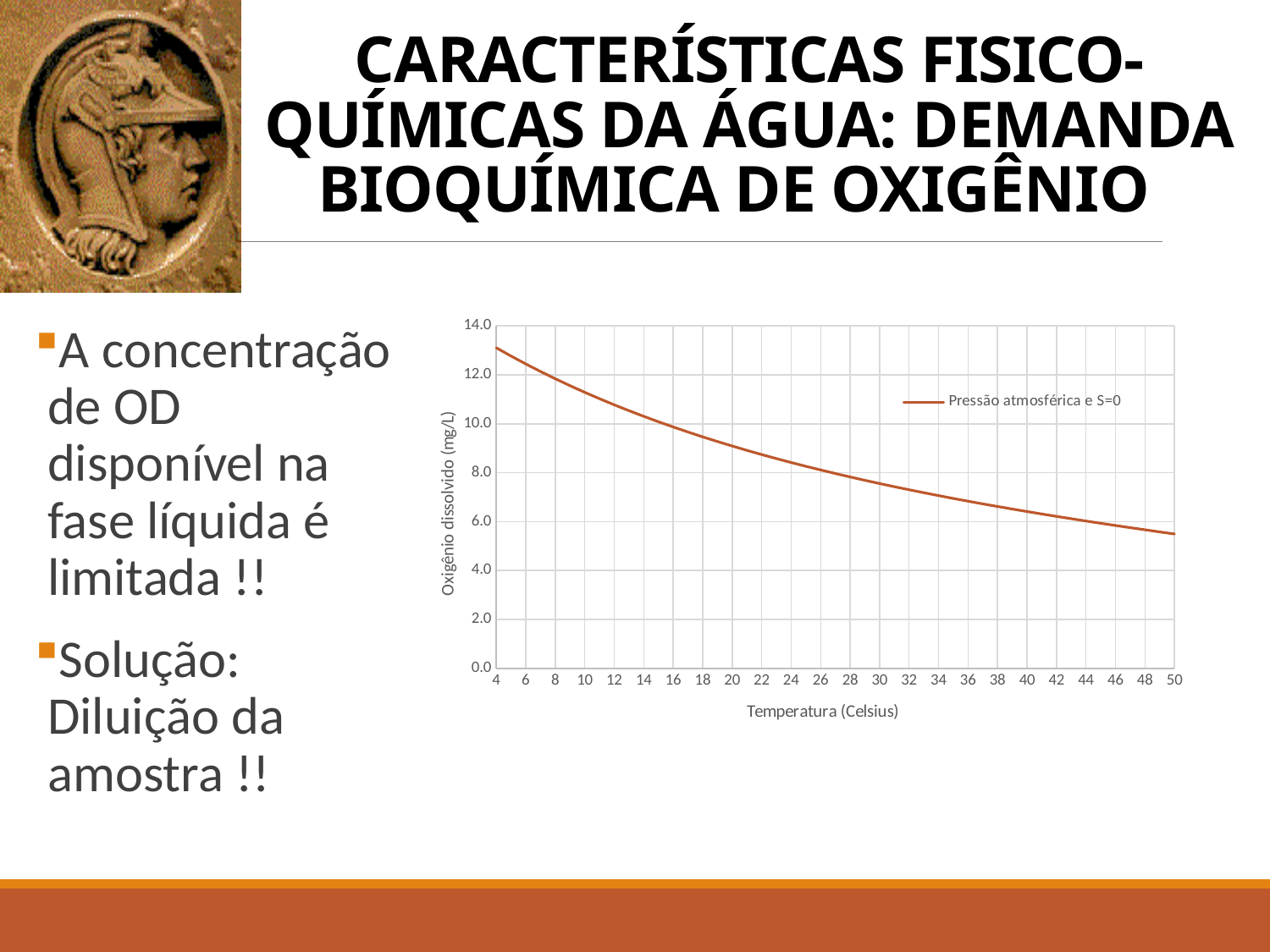
How many series does the chart legend list? 1 Is the dissolved oxygen value at 4 °C greater or less than 12.0? greater At which temperature on the x axis is the dissolved oxygen value highest? 4 What kind of chart is shown on the slide? line chart Is the dissolved oxygen value at 20 °C greater or less than 8.0? greater At which temperature on the x axis is the dissolved oxygen value lowest? 50 Is the dissolved oxygen value at 50 °C greater or less than 6.0? less Does dissolved oxygen rise or fall as temperature increases along the x axis? fall What is the title of the x axis of the chart? Temperatura (Celsius) What is the name of the series shown in the chart legend? Pressão atmosférica e S=0 Which is larger, the dissolved oxygen value at 10 °C or at 40 °C? 10 °C